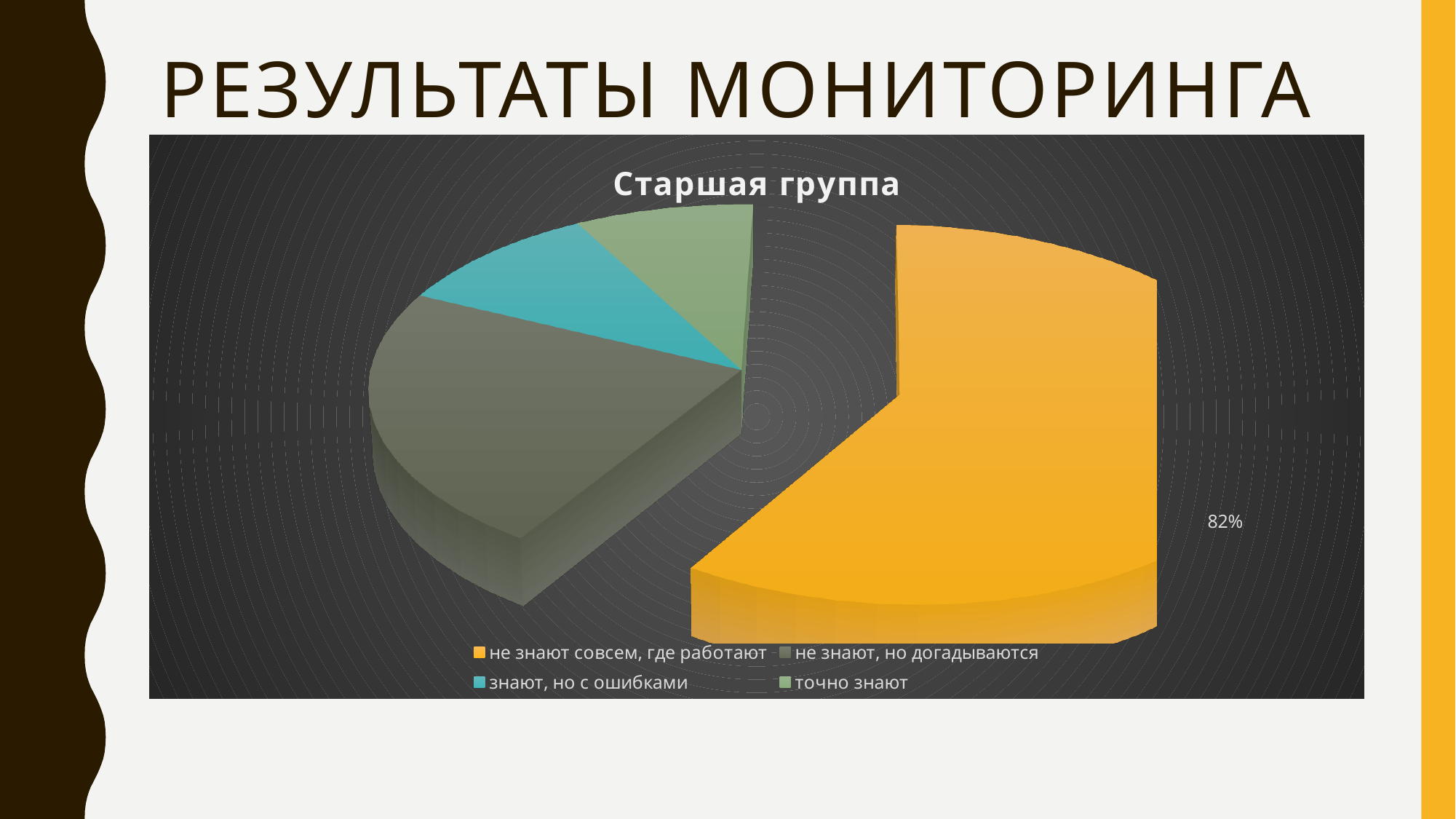
Which slice is larger: "не знают, но догадываются" or "знают, но с ошибками"? не знают, но догадываются Which slice is larger: "не знают совсем, где работают" or "точно знают"? не знают совсем, где работают Which slice is larger: "не знают, но догадываются" or "точно знают"? не знают, но догадываются Which category has the largest slice of the pie? не знают совсем, где работают Is the value for "не знают совсем, где работают" greater or less than 50%? greater What percentage is printed for the slice "не знают совсем, где работают"? 82% What is the title of the chart? Старшая группа How many categories does the legend of the chart list? 4 What kind of chart is shown on the slide? pie chart Which category is shown in orange on the chart? не знают совсем, где работают